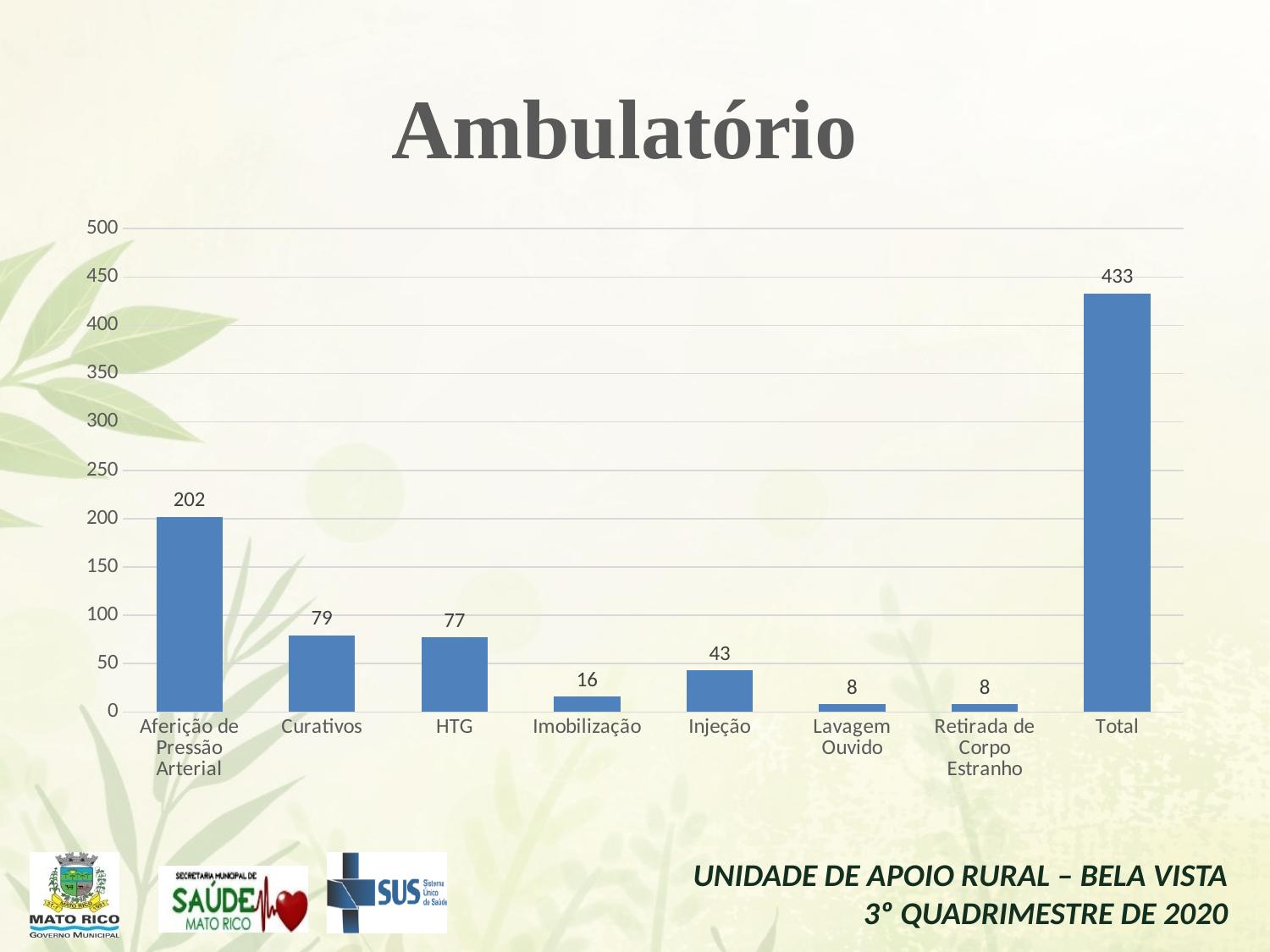
What is the difference between the values for Aferição de Pressão Arterial and Injeção? 159 How many bars are shown in the chart? 8 What is the value for Injeção? 43 What type of chart is shown on the slide? bar chart Which categories have the lowest value? Lavagem Ouvido and Retirada de Corpo Estranho What is the value for Curativos? 79 Is the value for Total greater or less than 400? greater Which is larger, the value for Imobilização or the value for Injeção? Injeção What is the value shown for the Total bar? 433 Excluding the Total bar, which category has the highest value? Aferição de Pressão Arterial What is the difference between the values for Curativos and HTG? 2 What is the value for Aferição de Pressão Arterial? 202